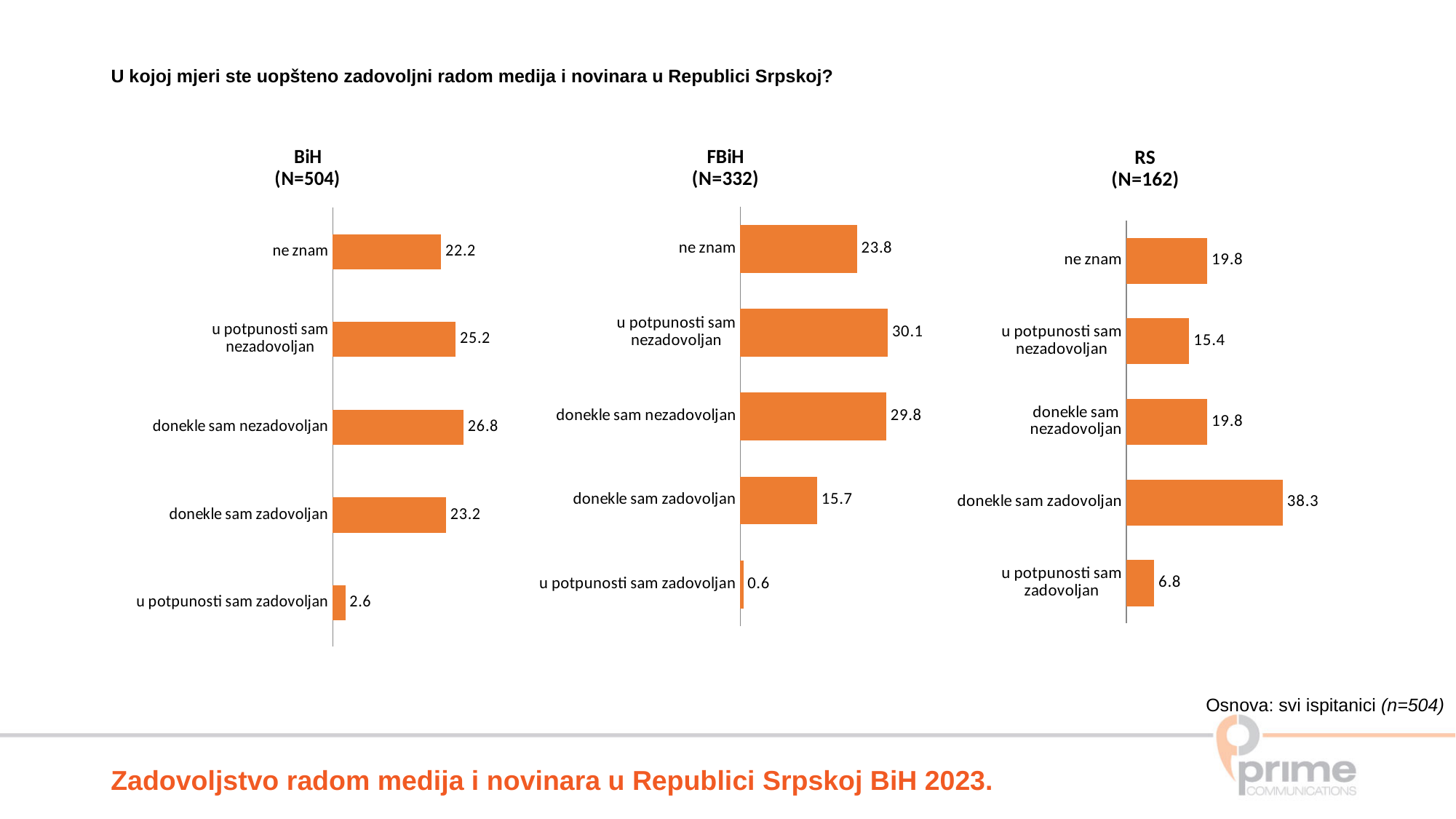
In the BiH (N=504) chart, which category has the lowest value? u potpunosti sam zadovoljan In the BiH (N=504) chart, what is the difference between "u potpunosti sam nezadovoljan" and "ne znam"? 3.0 In the FBiH (N=332) chart, which is larger: "ne znam" or "donekle sam zadovoljan"? ne znam How many categories are shown in the BiH (N=504) chart? 5 In the RS (N=162) chart, what is the value for "donekle sam zadovoljan"? 38.3 In the RS (N=162) chart, which category has the highest value? donekle sam zadovoljan How many charts are shown on the slide? 3 In the BiH (N=504) chart, what is the value for "donekle sam nezadovoljan"? 26.8 What type of chart is the FBiH (N=332) chart? bar chart In the RS (N=162) chart, what is the difference between "donekle sam zadovoljan" and "u potpunosti sam zadovoljan"? 31.5 In the FBiH (N=332) chart, what is the value for "u potpunosti sam zadovoljan"? 0.6 In the FBiH (N=332) chart, which category has the highest value? u potpunosti sam nezadovoljan